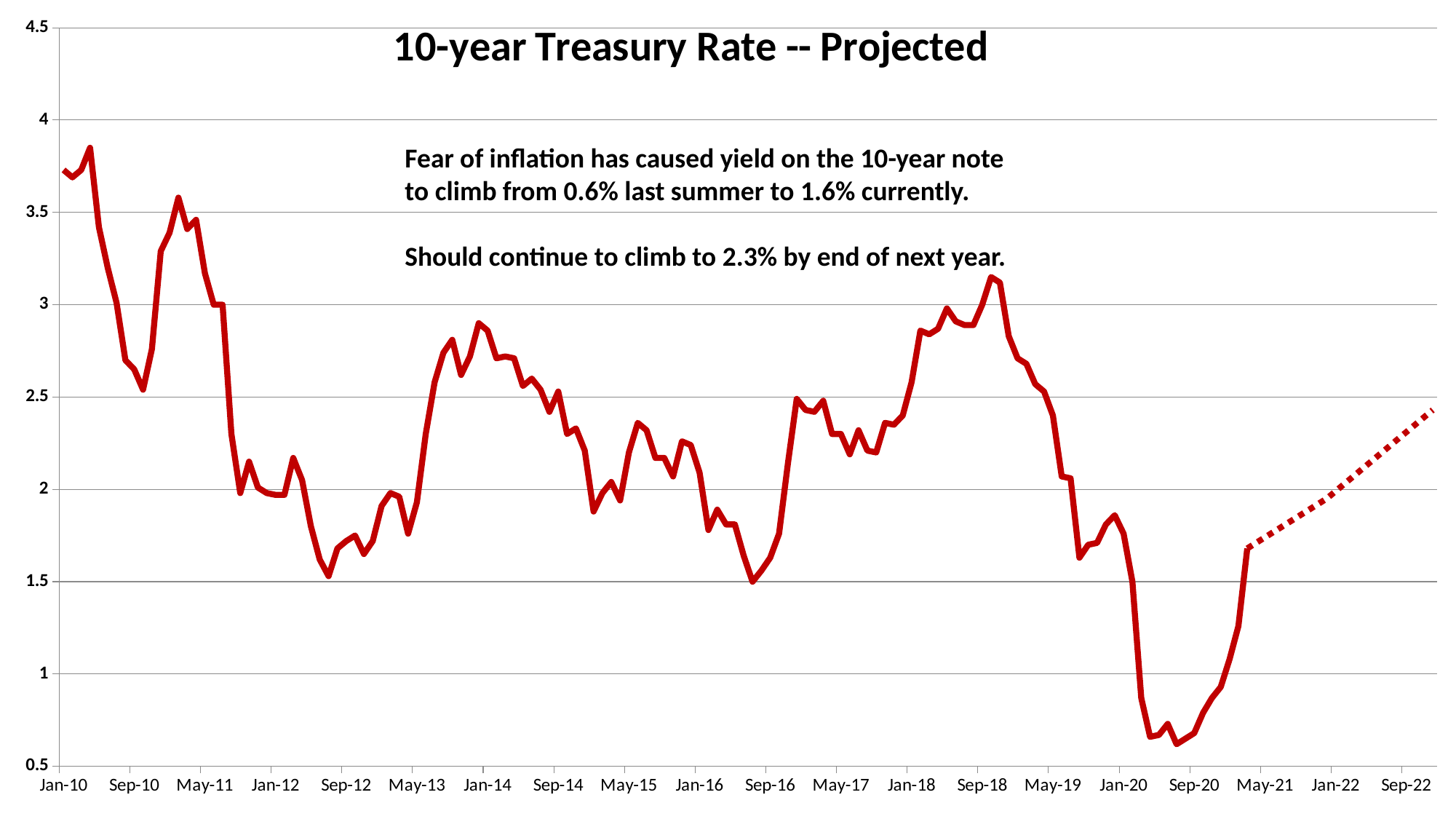
Does the projected dotted line rise or fall from May-21 to Sep-22? rise What kind of chart is shown on the slide? line chart What is the title of the chart? 10-year Treasury Rate -- Projected Is the value at Jan-10 greater or less than 3.5? greater Is the value at Sep-12 greater or less than 2? less Is the value at Jan-18 greater or less than 2.5? greater In which year does the line reach its highest value? 2010 What does the dotted portion of the line at the right end of the chart represent? projected values According to the slide text, to what rate is the 10-year yield expected to climb by the end of next year? 2.3% In which year does the line reach its lowest value? 2020